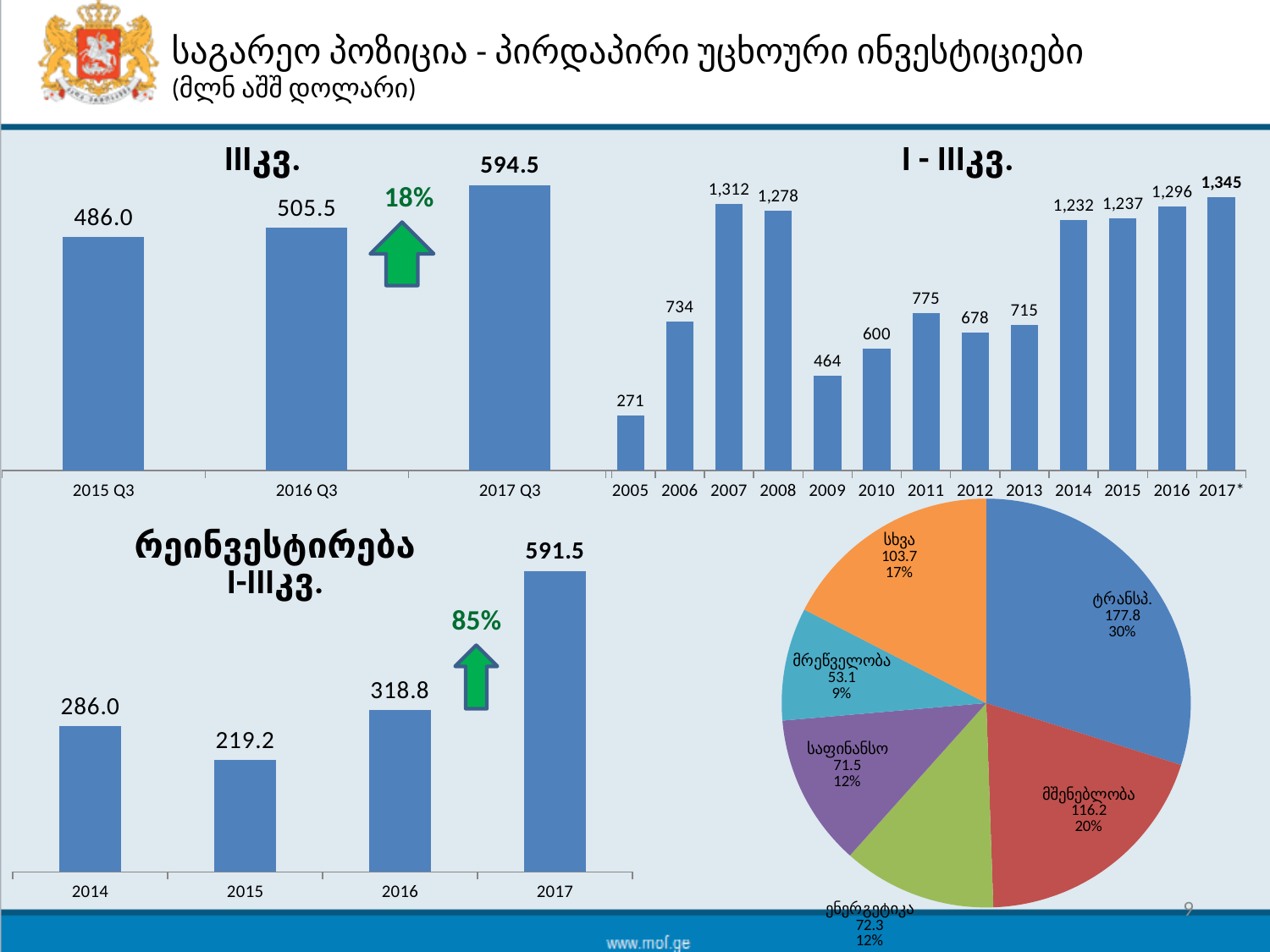
In the top-left bar chart (III კვ.), what is the value for 2017 Q3? 594.5 In the top-right bar chart (I - III კვ.), which is larger, the value for 2007 or the value for 2008? 2007 In the top-right bar chart (I - III კვ.), which year has the lowest value? 2005 In the bottom-left bar chart (რეინვესტირება I-III კვ.), what is the difference between the 2017 and 2016 values? 272.7 In the bottom-left bar chart (რეინვესტირება I-III კვ.), what is the value for 2015? 219.2 In the top-left bar chart (III კვ.), what is the difference between the 2017 Q3 and 2016 Q3 values? 89.0 What kind of chart is shown at the bottom right of the slide? Pie chart In the bottom-right pie chart, what share does ტრანსპ. have? 30% In the bottom-left bar chart (რეინვესტირება I-III კვ.), which year has the highest value? 2017 In the top-right bar chart (I - III კვ.), which year has the highest value? 2017* In the top-right bar chart (I - III კვ.), what is the value for 2009? 464 In the top-right bar chart (I - III კვ.), how many years are shown on the x axis? 13